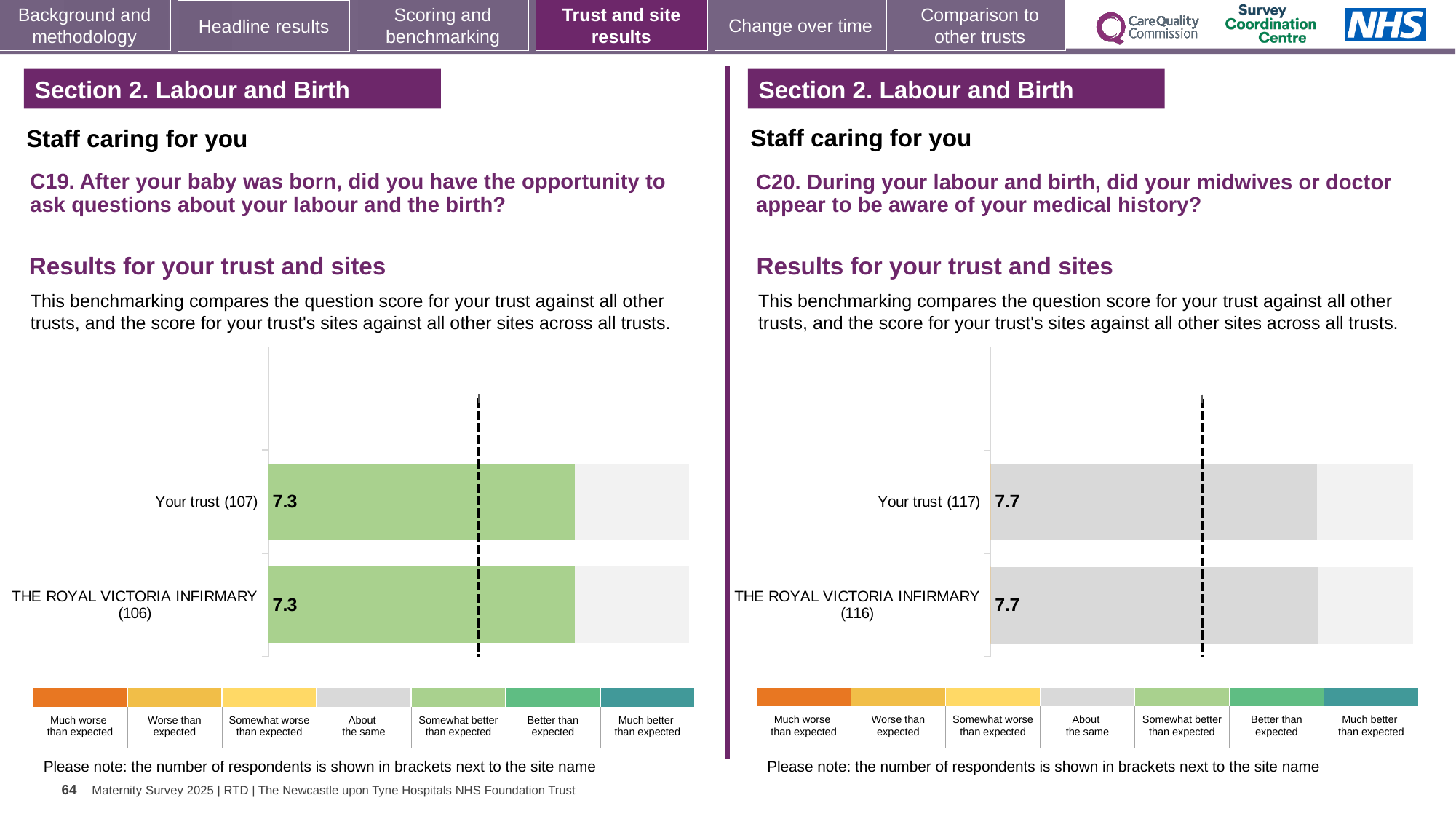
In the C20 chart on the right, what is the score for The Royal Victoria Infirmary? 7.7 How many bars are plotted in the C19 chart on the left? 2 In the C19 chart on the left, what is the score for The Royal Victoria Infirmary? 7.3 In the C19 chart on the left, what is the difference between the score for Your trust and the score for The Royal Victoria Infirmary? 0 In the C20 chart on the right, what is the difference between the score for Your trust and the score for The Royal Victoria Infirmary? 0 What kind of chart is used for the C19 results on the left? Bar chart How many bars are plotted in the C20 chart on the right? 2 In the C20 chart on the right, how many respondents are shown in brackets for Your trust? 117 In the C20 chart on the right, what is the score for Your trust? 7.7 According to the colour key, which benchmark category do the bars in the C20 chart on the right fall into? About the same In the C19 chart on the left, what is the score for Your trust? 7.3 In the C19 chart on the left, how many respondents are shown in brackets for The Royal Victoria Infirmary? 106